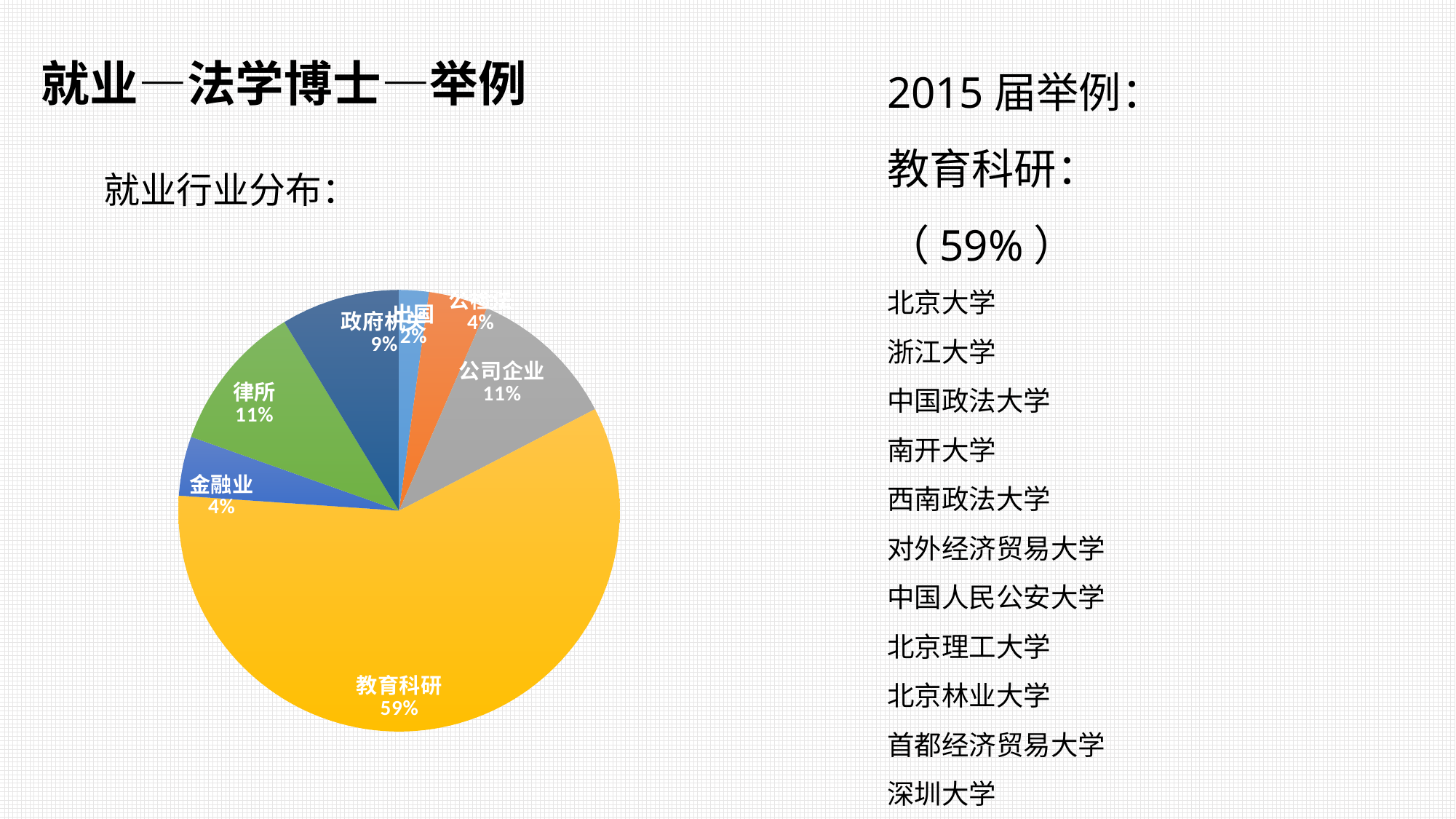
How many slices does the pie chart have? 7 How many percentage points larger is 教育科研 than 公司企业? 48 percentage points What is the difference between 律所 and 金融业? 7 percentage points Which is larger, 律所 or 金融业? 律所 What is the value shown for 政府机关? 9% What is the heading shown above the pie chart? 就业行业分布 What is the value shown for 公司企业? 11% Which category has the largest slice of the pie? 教育科研 What kind of chart is shown on the slide? pie chart What is the value shown for 金融业? 4% What share of the pie does 教育科研 have? 59% What is the value shown for 律所? 11%